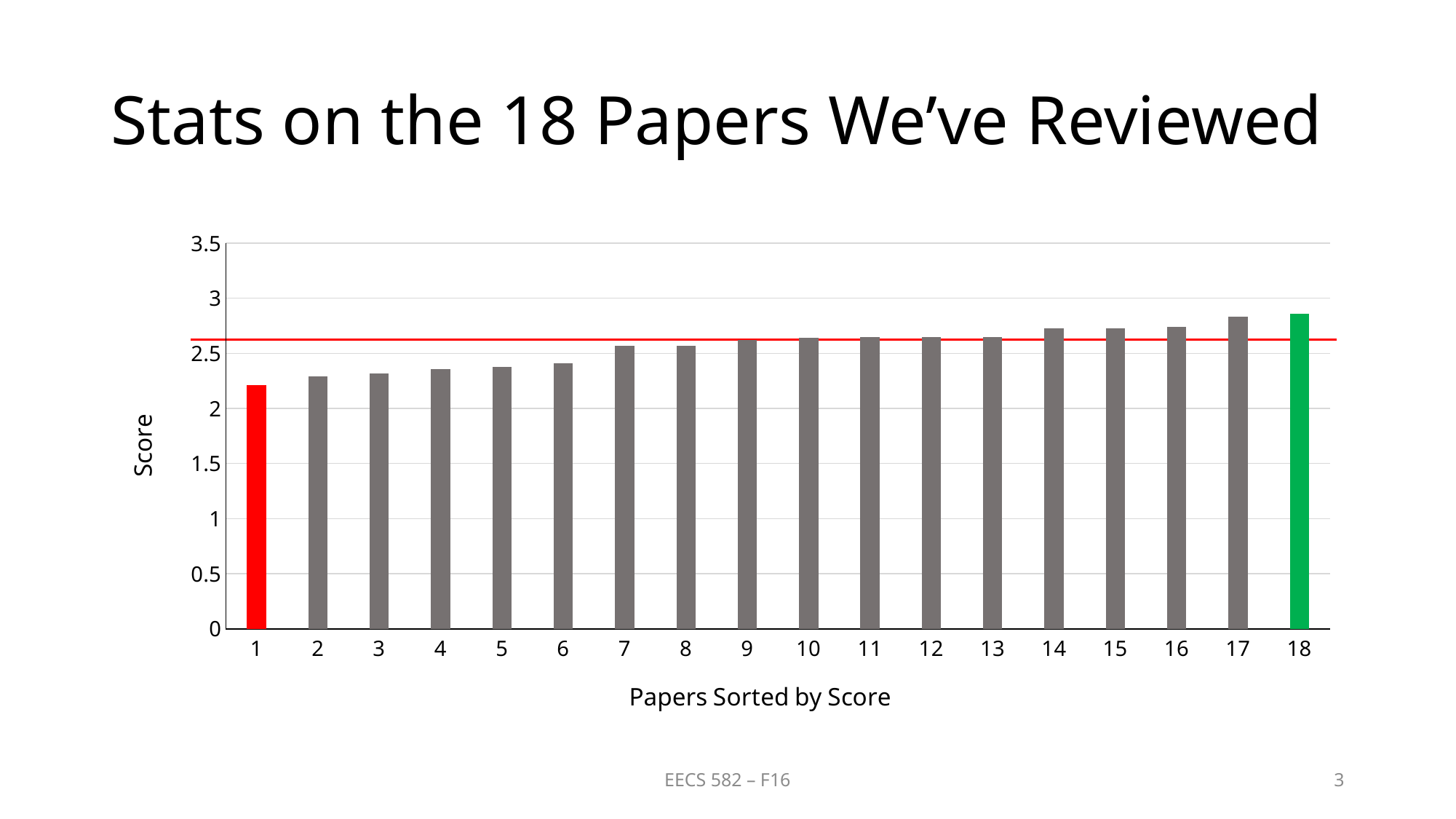
What kind of chart is shown on the slide? bar chart Is the score for paper 6 greater or less than 2.5? less What colour is the bar for paper 18? green What is the label of the x axis? Papers Sorted by Score Do the scores rise or fall from paper 1 to paper 18 along the x axis? rise Which paper has the lowest score? 1 Is the score for paper 1 greater or less than 2.5? less Which has a higher score, paper 3 or paper 16? paper 16 Is the score for paper 18 greater or less than 3? less Which paper has the highest score? 18 How many papers (bars) are plotted in the chart? 18